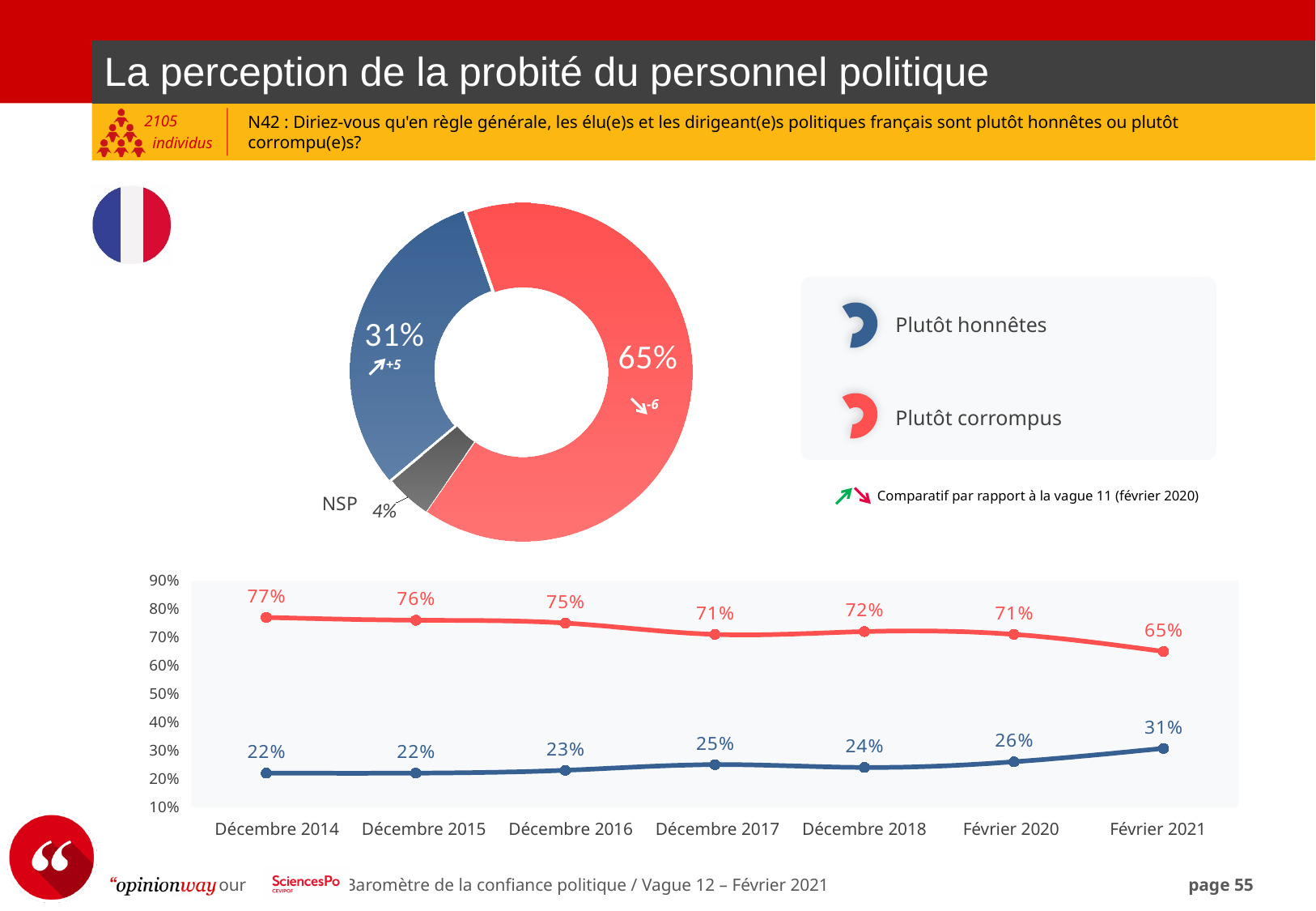
In the donut chart, what share of respondents answered "Plutôt corrompus"? 65% In the donut chart, which category has the largest share? Plutôt corrompus What kind of chart is shown at the bottom of the slide? Line chart In the line chart, does the blue (Plutôt honnêtes) line rise or fall from Décembre 2014 to Février 2021? Rises In the donut chart, what is the difference between the "Plutôt corrompus" and "Plutôt honnêtes" shares? 34 percentage points In the line chart, what is the value of the blue (Plutôt honnêtes) line for Février 2020? 26% In the donut chart, what is the value of the NSP slice? 4% In the line chart, at which time point is the red (Plutôt corrompus) line lowest? Février 2021 In the line chart, what is the difference between the red line values for Décembre 2018 and Février 2021? 7 percentage points In the line chart, how many time points are shown on the x axis? 7 In the line chart, what is the value of the red (Plutôt corrompus) line for Décembre 2014? 77% In the donut chart, what share of respondents answered "Plutôt honnêtes"? 31%